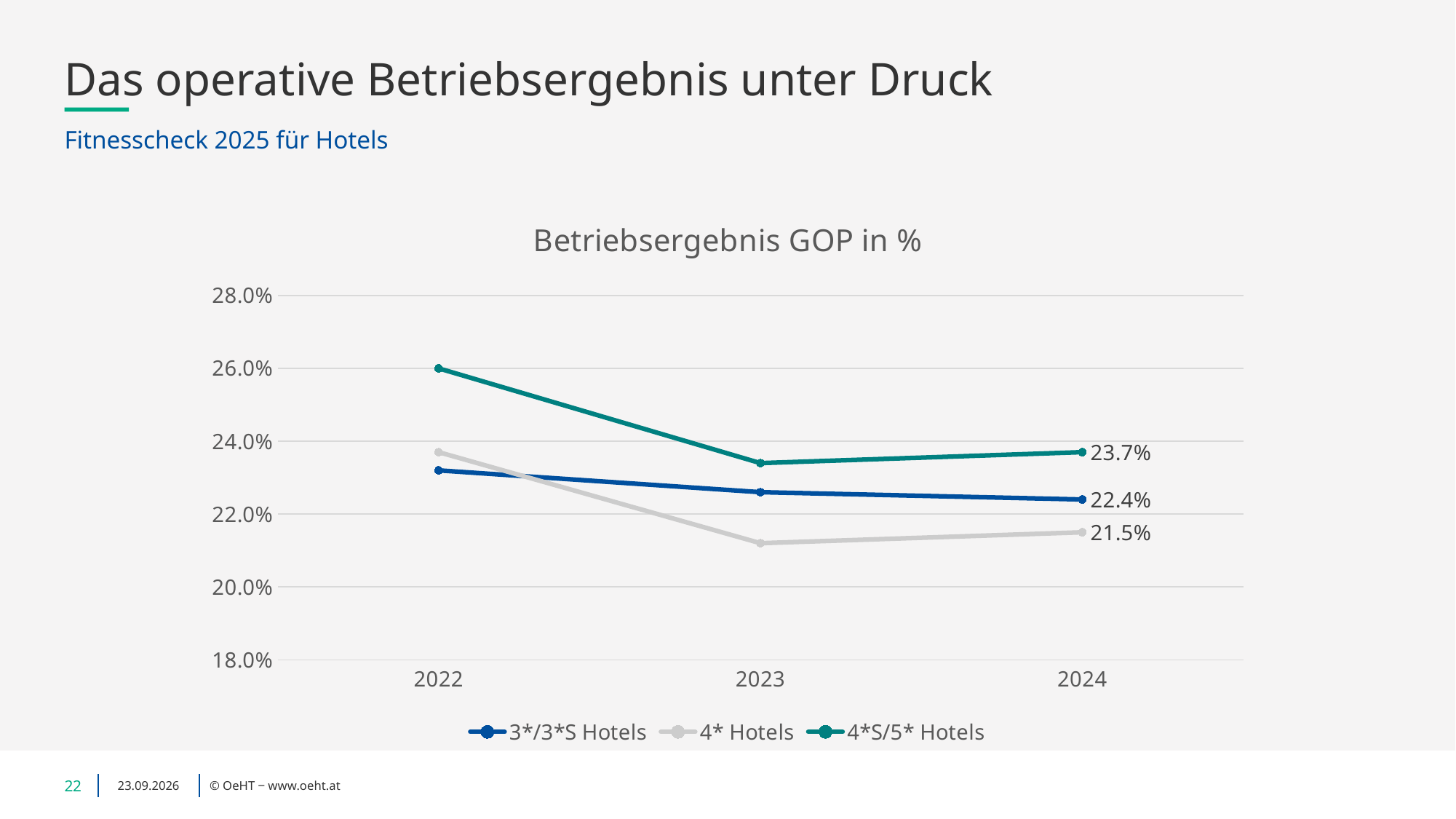
What is the GOP value for 4* Hotels in 2024? 21.5% What kind of chart is shown on the slide? line chart What is the difference between the 2024 values of 4*S/5* Hotels and 4* Hotels? 2.2 percentage points Which hotel category has the highest GOP in 2024? 4*S/5* Hotels Is the value for 4* Hotels in 2023 greater or less than 22.0%? less Is the value for 4*S/5* Hotels in 2022 greater or less than 24.0%? greater What is the GOP value for 3*/3*S Hotels in 2024? 22.4% How many years are shown on the x axis? 3 Which hotel category has the lowest GOP in 2024? 4* Hotels Does the line for 4*S/5* Hotels rise or fall from 2022 to 2023? fall How many series does the legend list? 3 What is the GOP value for 4*S/5* Hotels in 2024? 23.7%